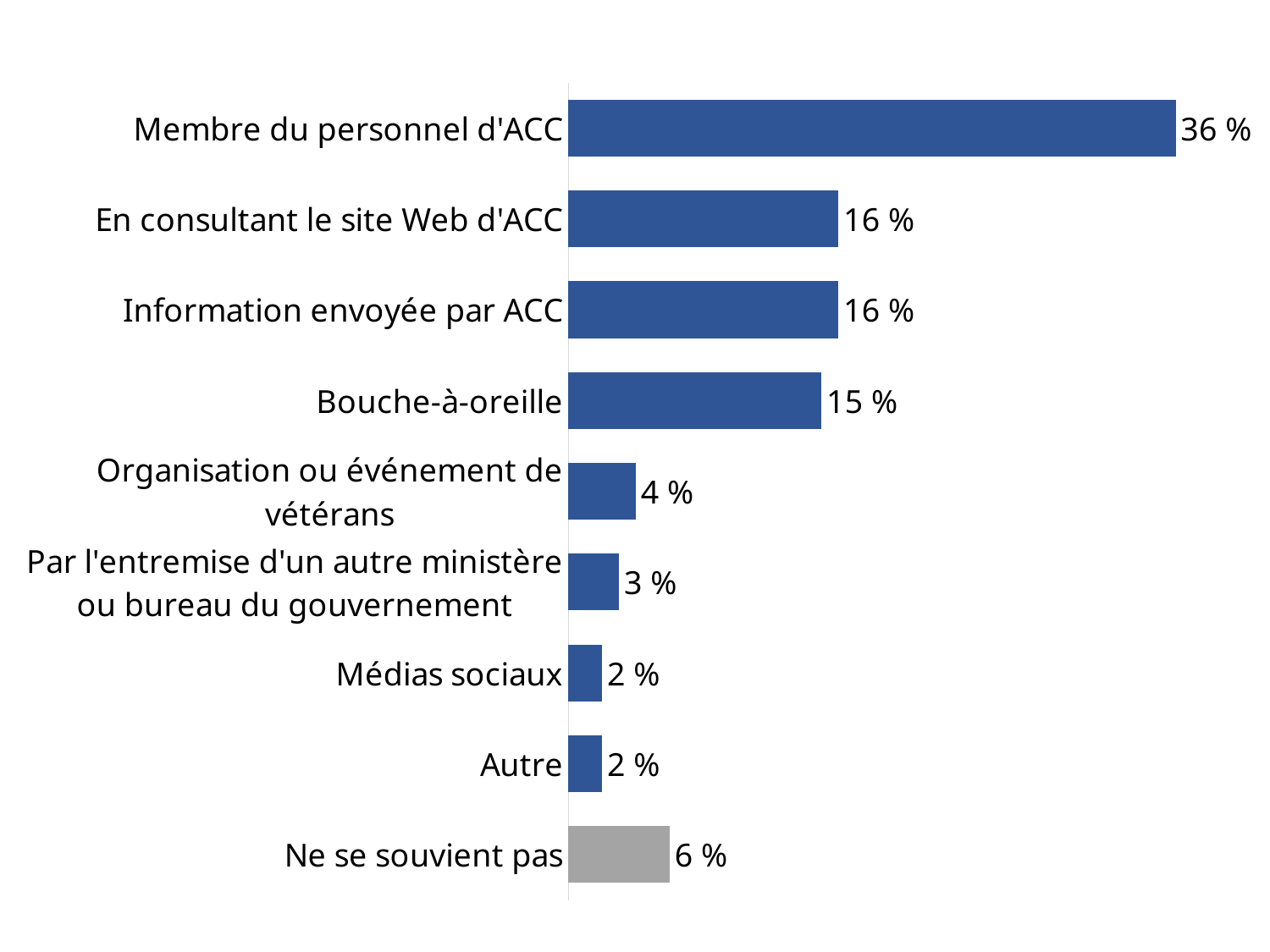
What is the difference between "Membre du personnel d'ACC" and "En consultant le site Web d'ACC"? 20 % What is the value for "Membre du personnel d'ACC"? 36 % What is the value for "Organisation ou événement de vétérans"? 4 % What kind of chart is this? Bar chart What is the value for "Bouche-à-oreille"? 15 % Which is larger, "Bouche-à-oreille" or "Par l'entremise d'un autre ministère ou bureau du gouvernement"? Bouche-à-oreille What is the value for "Information envoyée par ACC"? 16 % How many categories are shown in the chart? 9 Which bar is shown in grey rather than blue? Ne se souvient pas Which category has the highest value? Membre du personnel d'ACC What is the difference between "Ne se souvient pas" and "Médias sociaux"? 4 % What is the value for "Ne se souvient pas"? 6 %